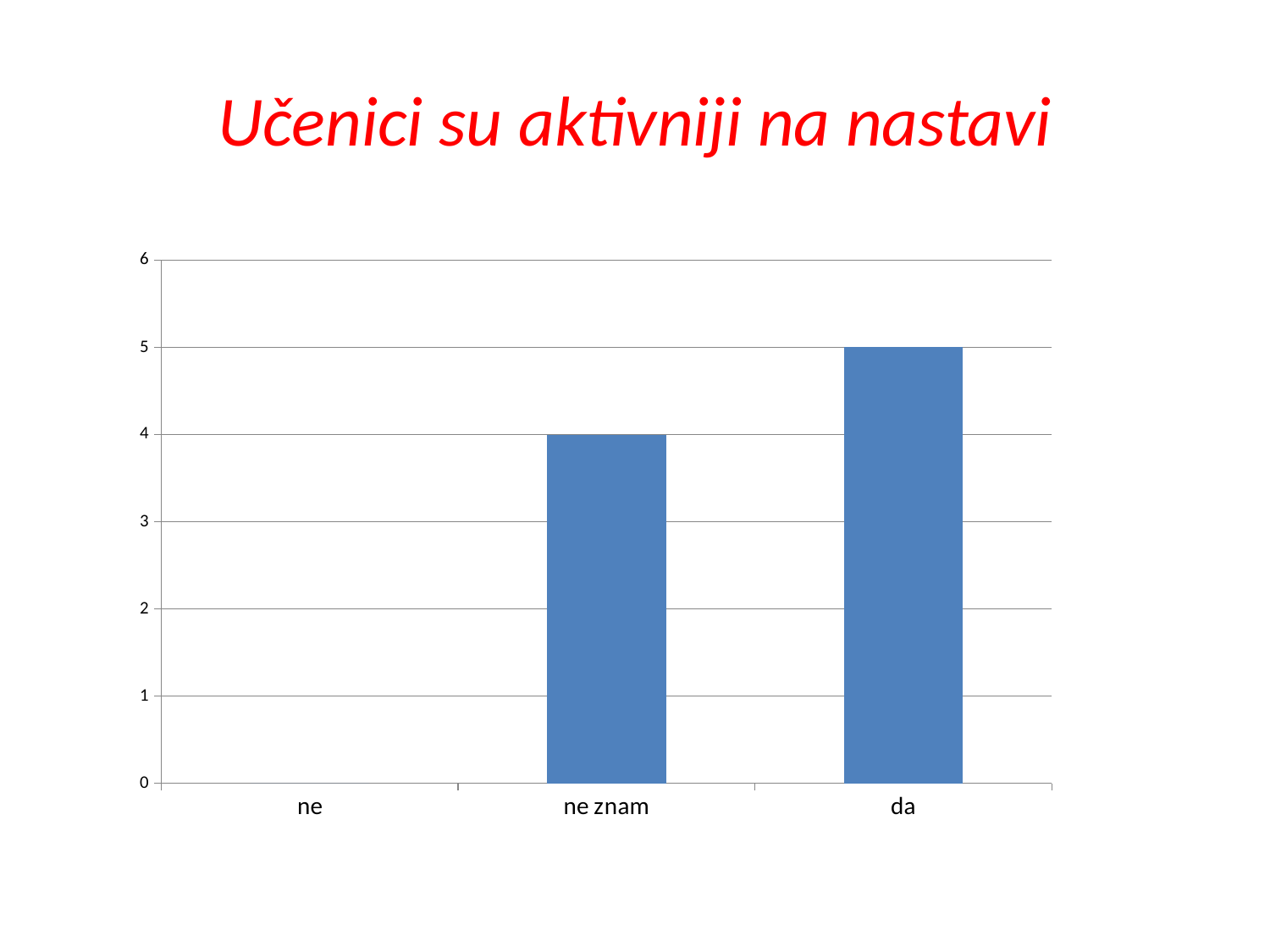
Do the values rise or fall from left to right along the x axis? rise How many categories are shown on the x axis of the chart? 3 Which category has the lowest value? ne What is the title shown above the chart on the slide? Učenici su aktivniji na nastavi Is the value for "da" greater or less than 3? greater What is the difference between the values for "da" and "ne znam"? 1 Which category has the highest value? da What is the value for "ne"? 0 What kind of chart is shown on the slide? bar chart What is the value for "ne znam"? 4 Which is larger, the value for "ne znam" or the value for "da"? da What is the value for "da"? 5